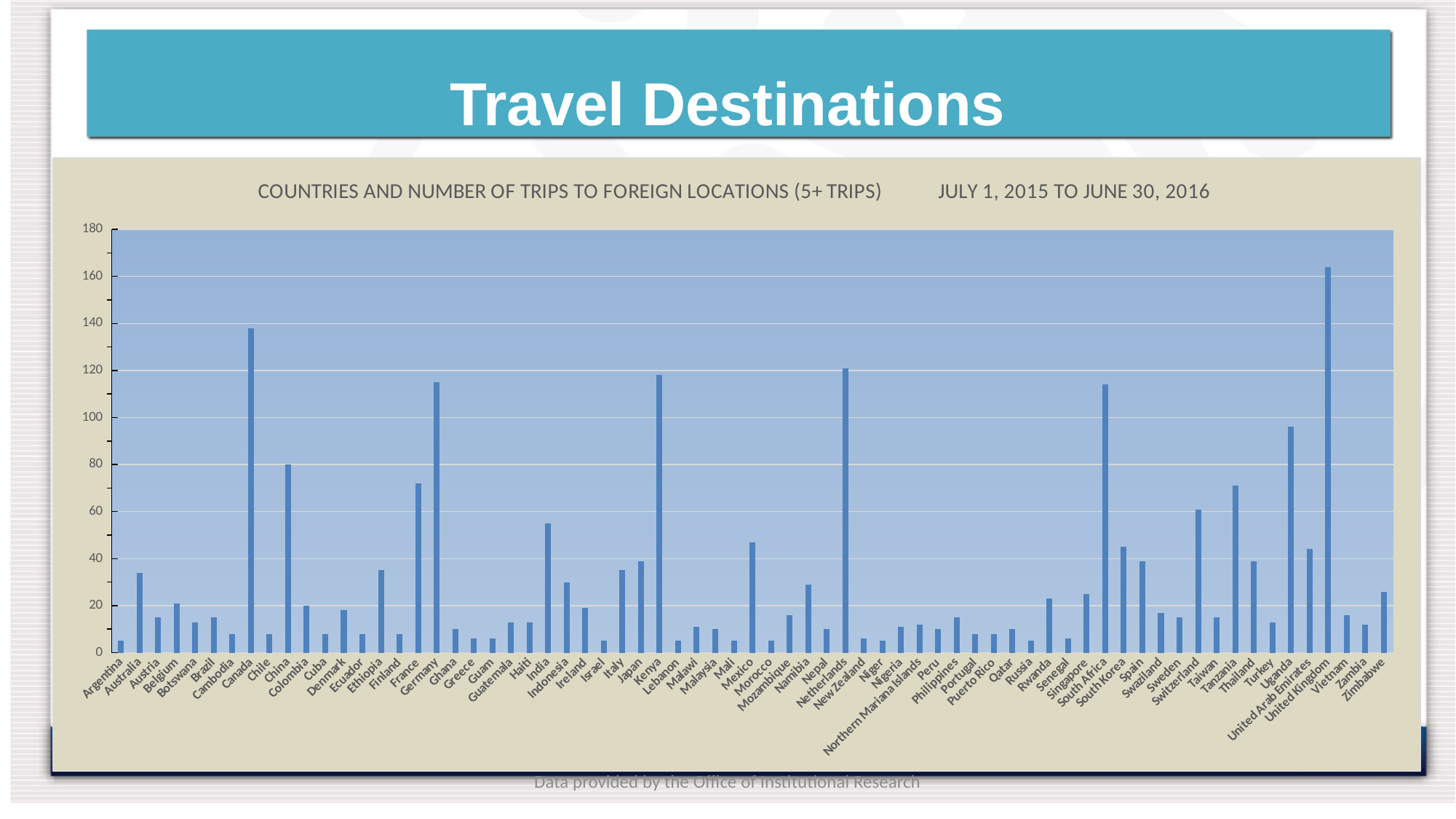
Is the value for India greater or less than 60? less Which has more trips, France or India? France What kind of chart is shown on the slide? Bar chart Is the value for Canada greater or less than 120? greater Which country has the highest number of trips in the chart? United Kingdom Which has more trips, Canada or Germany? Canada Is the value for Germany greater or less than 120? less What date range does the chart title say the data covers? July 1, 2015 to June 30, 2016 Which has more trips, South Africa or Uganda? South Africa